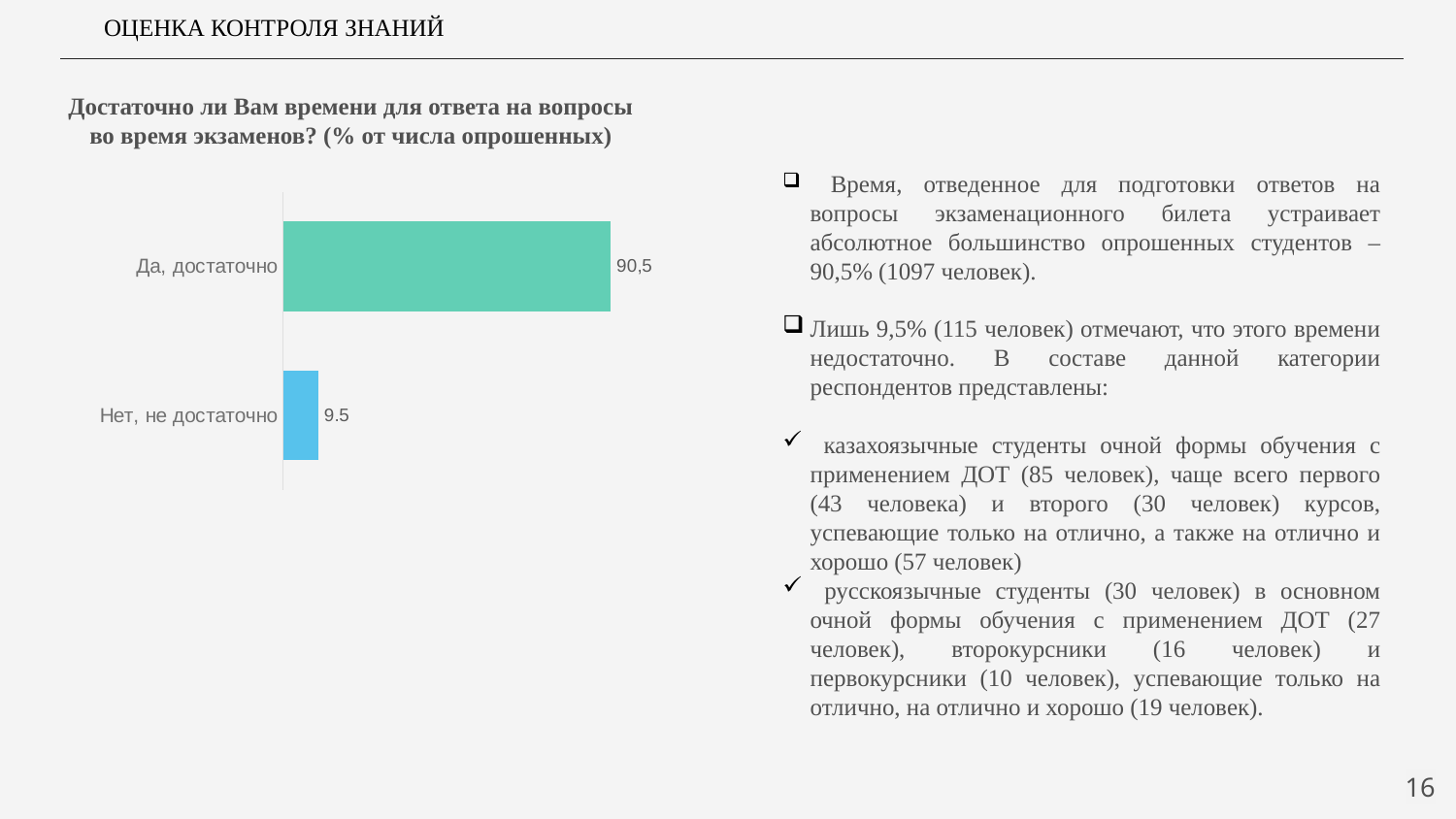
What value is shown for "Да, достаточно"? 90,5 What value is shown for "Нет, не достаточно"? 9.5 What kind of chart is shown on the slide? Bar chart How many categories are shown in the chart? 2 What is the difference between the values for "Да, достаточно" and "Нет, не достаточно"? 81 What colour is the bar for "Нет, не достаточно"? Blue Which category has the lowest value? Нет, не достаточно What is the title of the chart? Достаточно ли Вам времени для ответа на вопросы во время экзаменов? (% от числа опрошенных) Which category has the highest value? Да, достаточно Which is larger: the value for "Да, достаточно" or for "Нет, не достаточно"? Да, достаточно